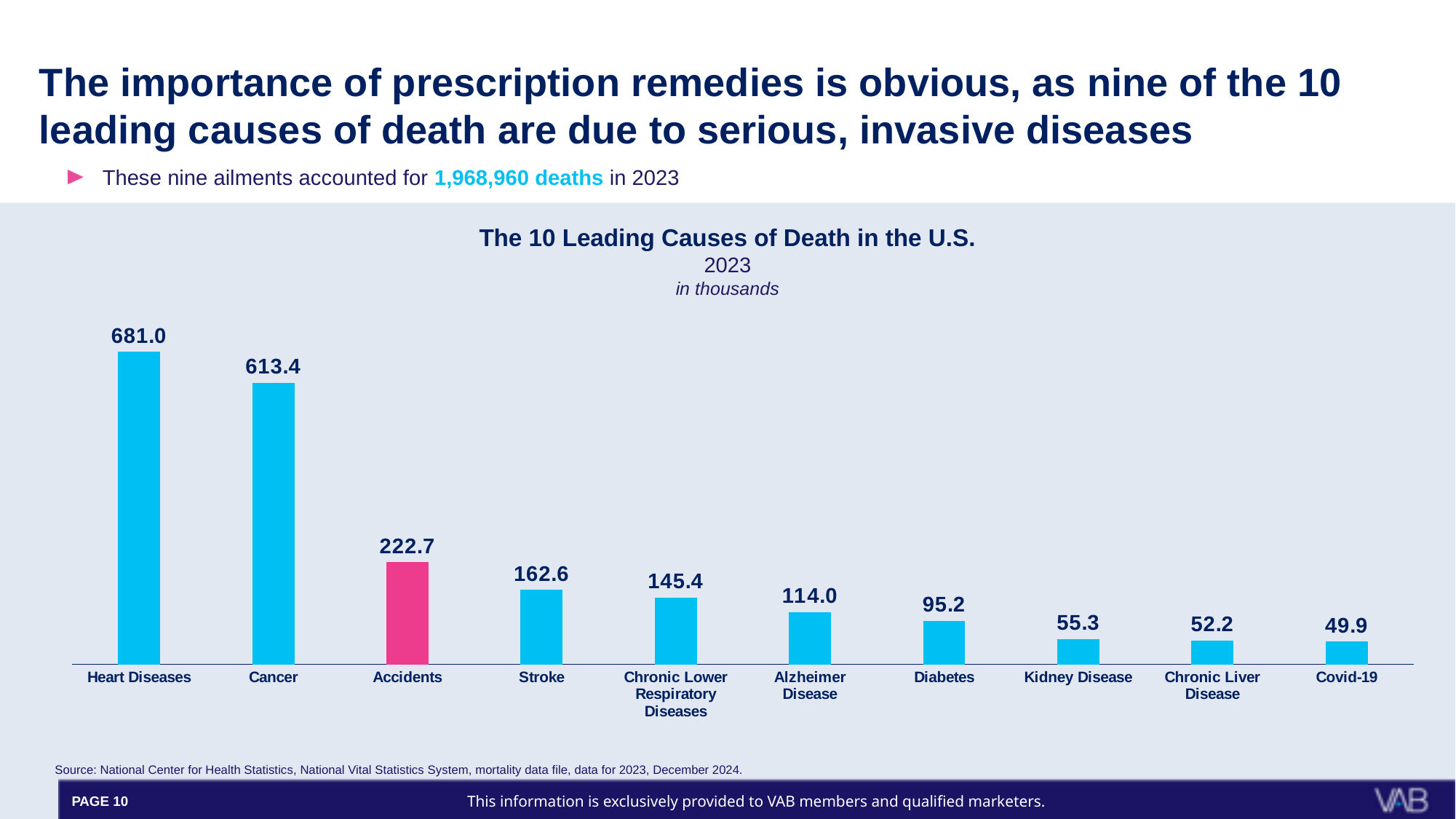
What is the difference between the values for Accidents and Stroke? 60.1 What is the value for Heart Diseases? 681.0 Which cause of death has the highest value? Heart Diseases What is the difference between the values for Heart Diseases and Cancer? 67.6 Which cause of death has the lowest value? Covid-19 Do the values rise or fall from left to right along the x axis? Fall What kind of chart is shown on the slide? Bar chart What is the value for Kidney Disease? 55.3 Which bar is shown in a different colour (pink) from the others? Accidents Which is larger, the value for Alzheimer Disease or the value for Diabetes? Alzheimer Disease What is the value for Stroke? 162.6 How many causes of death are shown in the chart? 10